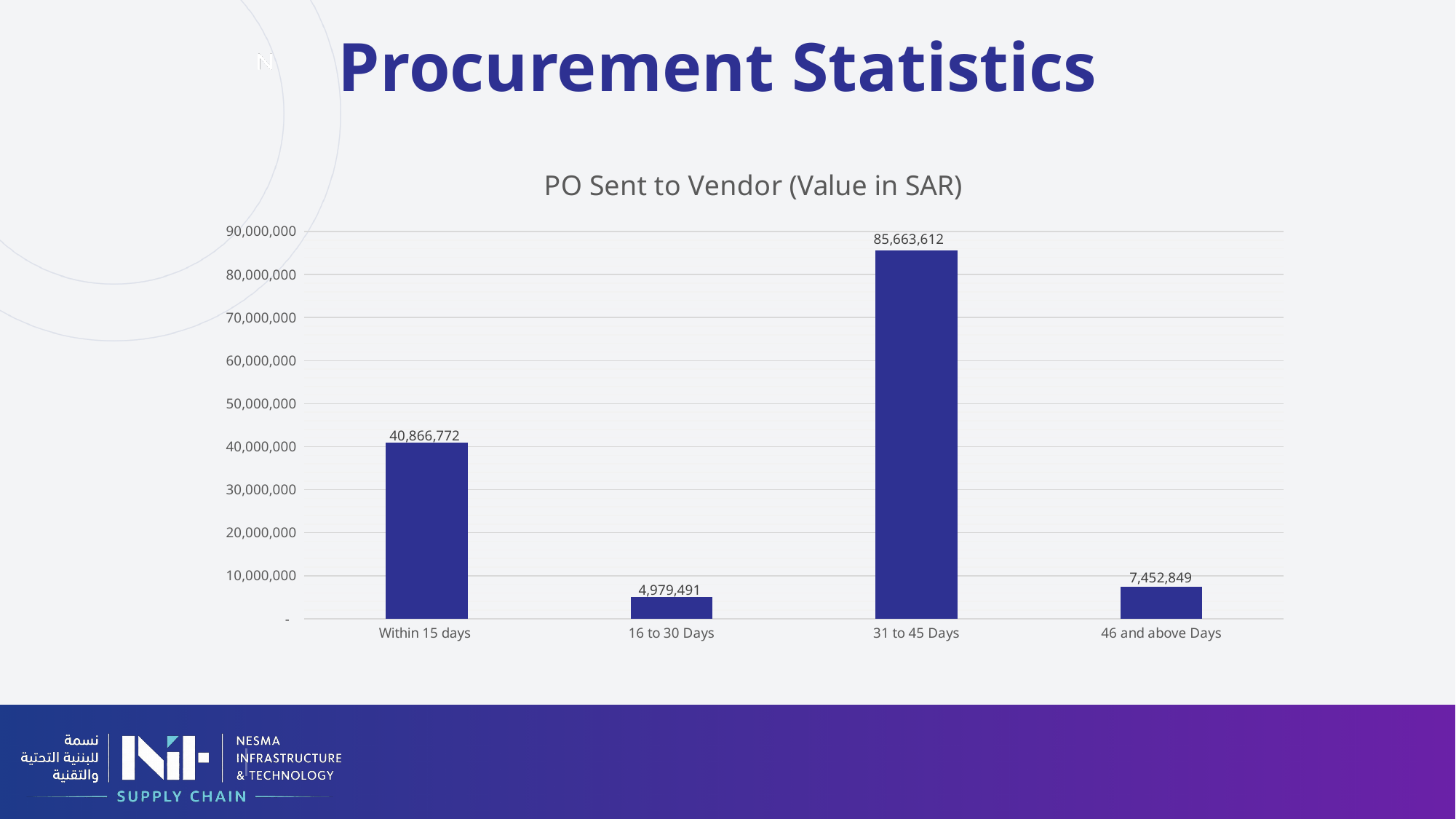
What type of chart is shown on the slide? Bar chart Which category has the lowest PO value? 16 to 30 Days Which category has the highest PO value? 31 to 45 Days What is the value for '31 to 45 Days'? 85,663,612 Which is larger, the value for 'Within 15 days' or the value for '46 and above Days'? Within 15 days What is the value for 'Within 15 days' in the PO Sent to Vendor chart? 40,866,772 What is the difference between the values for '31 to 45 Days' and 'Within 15 days'? 44,796,840 What is the value for '16 to 30 Days'? 4,979,491 How many categories are shown on the x axis of the chart? 4 What is the value for '46 and above Days'? 7,452,849 What is the difference between the values for '46 and above Days' and '16 to 30 Days'? 2,473,358 Is the value for '31 to 45 Days' greater or less than 80,000,000? greater